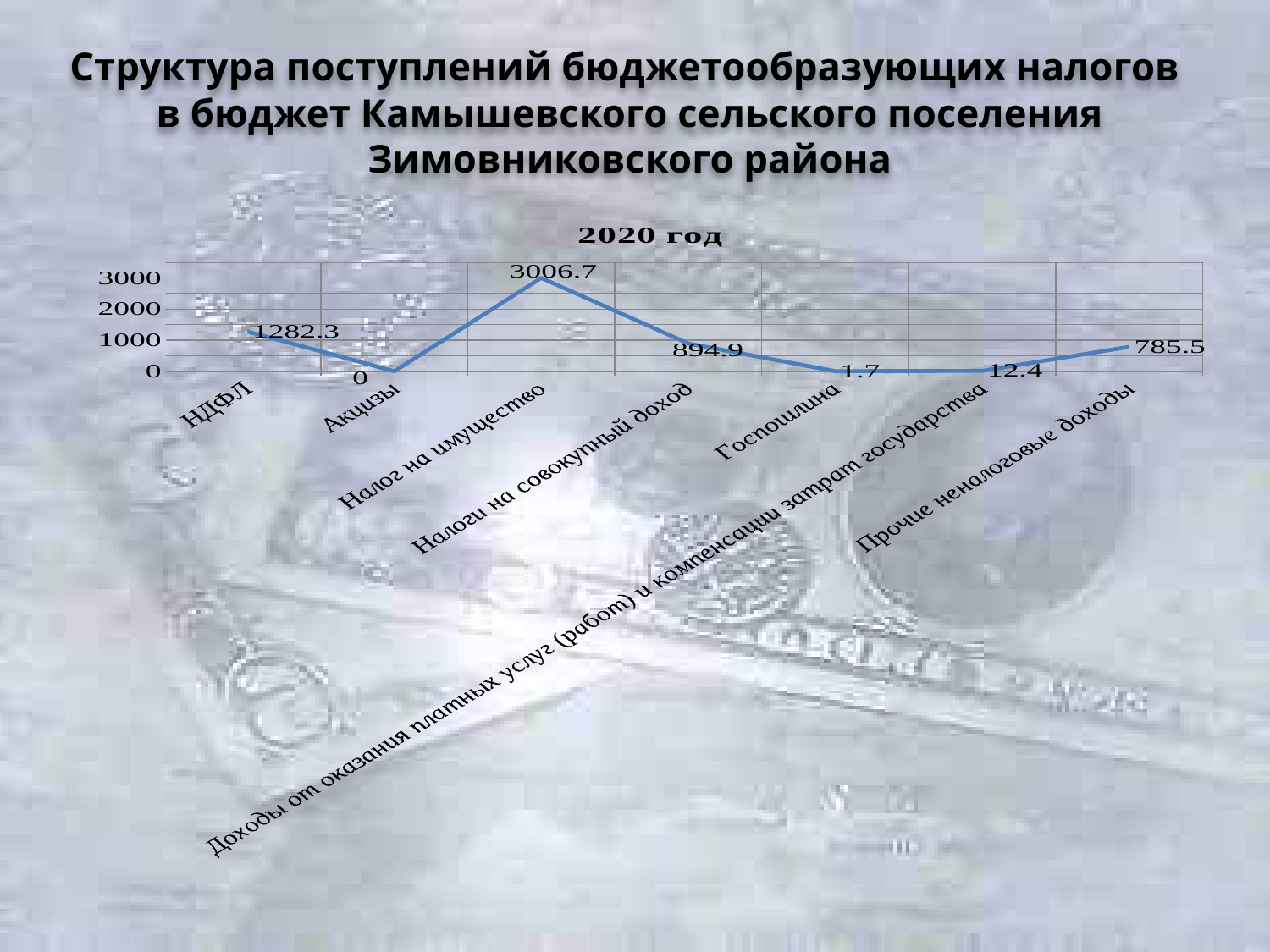
What is the value for НДФЛ in the 2020 год chart? 1282.3 What is the value for Налог на имущество? 3006.7 What is the value for Налоги на совокупный доход? 894.9 Which category has the highest value? Налог на имущество Which category has the lowest value? Акцизы What is the difference between the values for Налог на имущество and НДФЛ? 1724.4 What is the value for Госпошлина? 1.7 How many categories are plotted on the chart? 7 Which is larger, the value for Налоги на совокупный доход or the value for Прочие неналоговые доходы? Налоги на совокупный доход What kind of chart is shown on the slide? Line chart What is the title of the chart? 2020 год What is the value for Прочие неналоговые доходы? 785.5